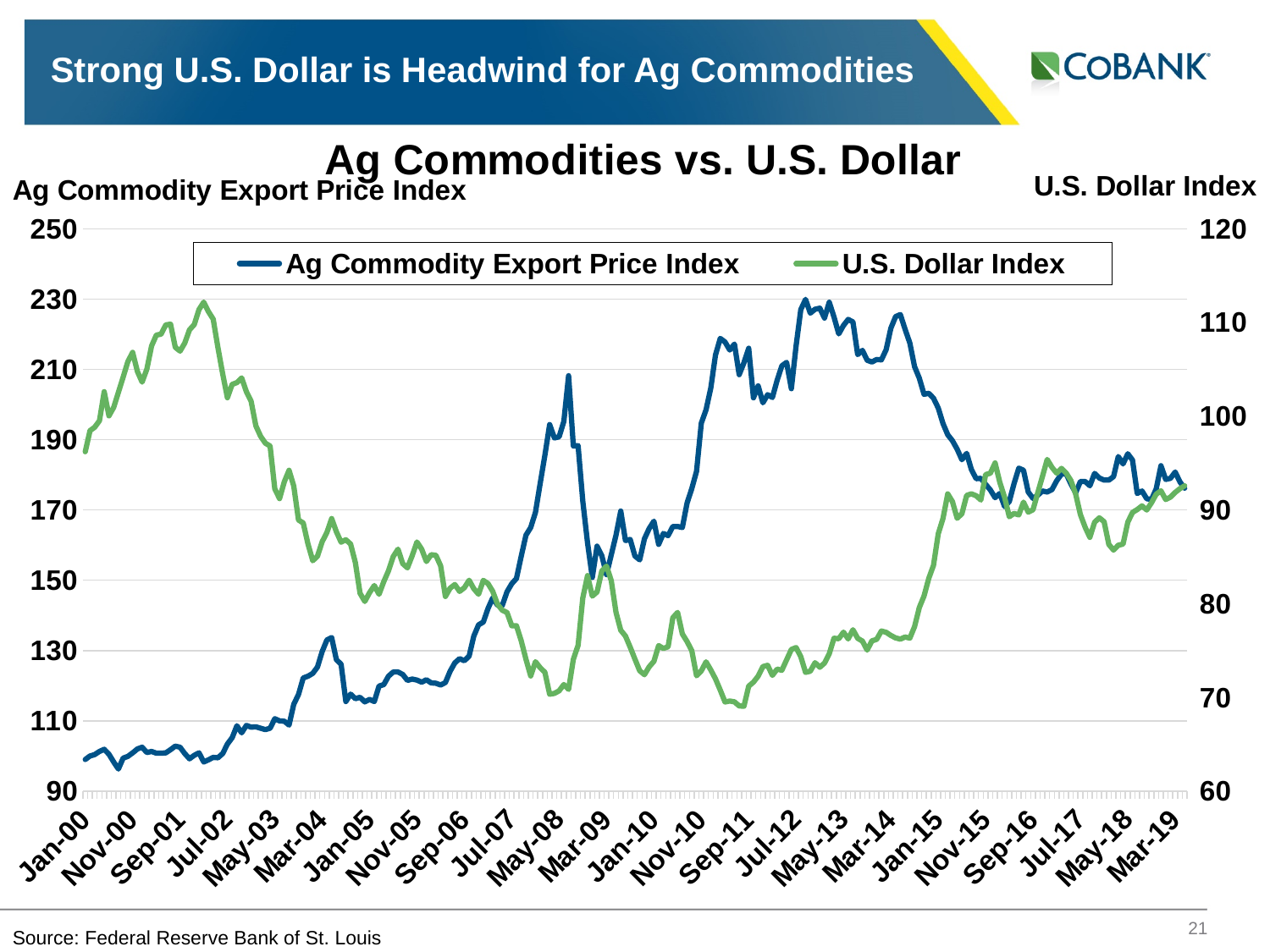
Which series is plotted in green? U.S. Dollar Index What is the title of the chart? Ag Commodities vs. U.S. Dollar Does the Ag Commodity Export Price Index rise or fall between Jul-12 and Nov-15? fall What kind of chart is shown on the slide? line chart Is the U.S. Dollar Index value at Jan-00 greater or less than 90? greater How many series does the legend list? 2 Is the U.S. Dollar Index value around Jul-02 greater or less than 100? greater Does the Ag Commodity Export Price Index rise or fall between Jan-00 and Mar-04? rise Is the Ag Commodity Export Price Index value at Jan-00 greater or less than 130? less Does the U.S. Dollar Index rise or fall between Jul-02 and Jan-05? fall